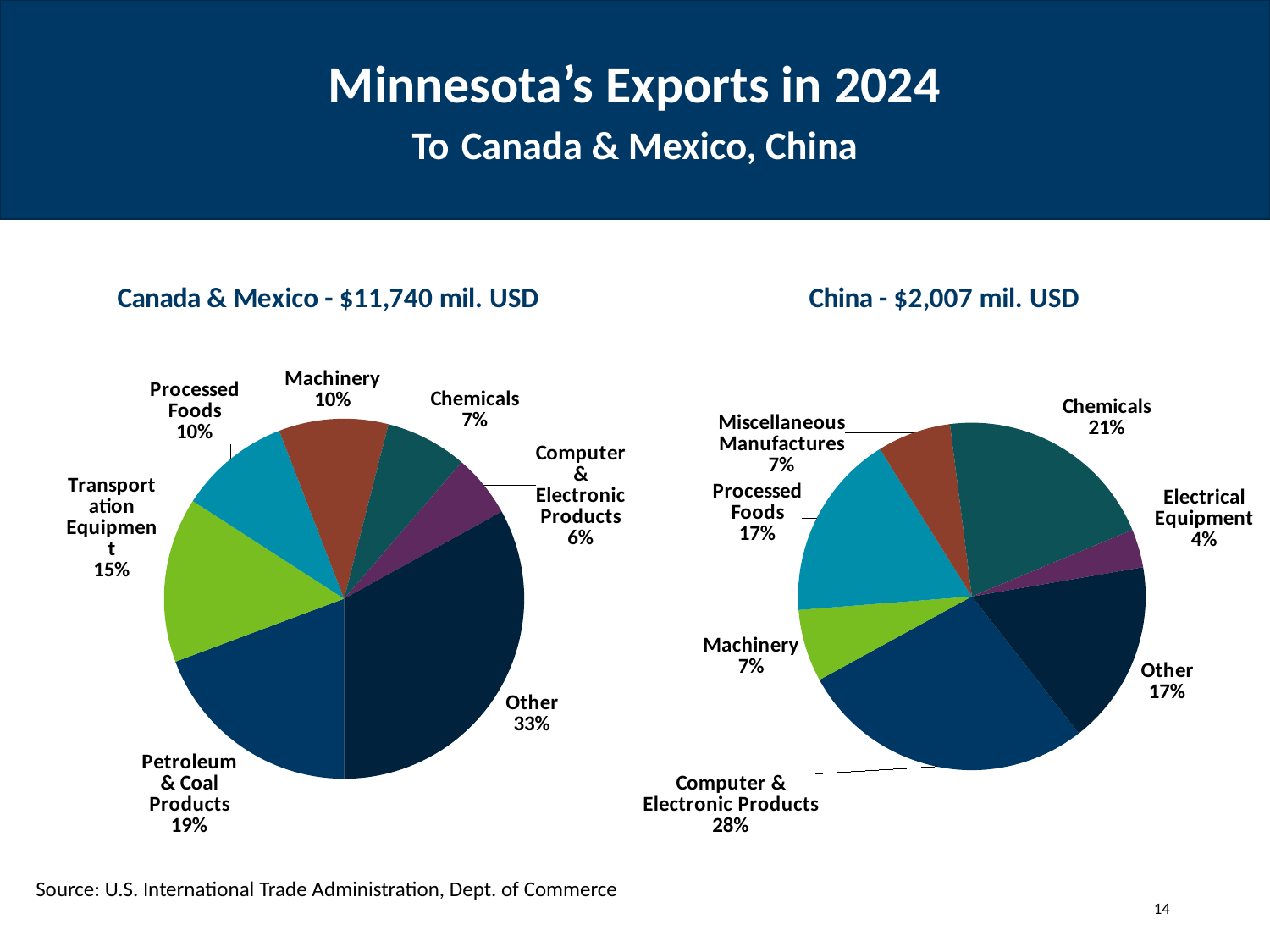
On the China chart, what share of exports is Computer & Electronic Products? 28% On the China chart, which category has the smallest slice? Electrical Equipment On the China chart, what is the difference in percentage points between Chemicals and Machinery? 14 How many slices does the China chart have? 7 What total export value is shown in the title of the Canada & Mexico chart? $11,740 mil. USD What total export value is shown in the title of the China chart? $2,007 mil. USD On the Canada & Mexico chart, which category has the largest slice? Other On the Canada & Mexico chart, what share of exports is Petroleum & Coal Products? 19% On the China chart, what share of exports is Processed Foods? 17% On the Canada & Mexico chart, which category has the smallest slice? Computer & Electronic Products On the Canada & Mexico chart, which is larger, Transportation Equipment or Processed Foods? Transportation Equipment What kind of chart is the Canada & Mexico chart? Pie chart